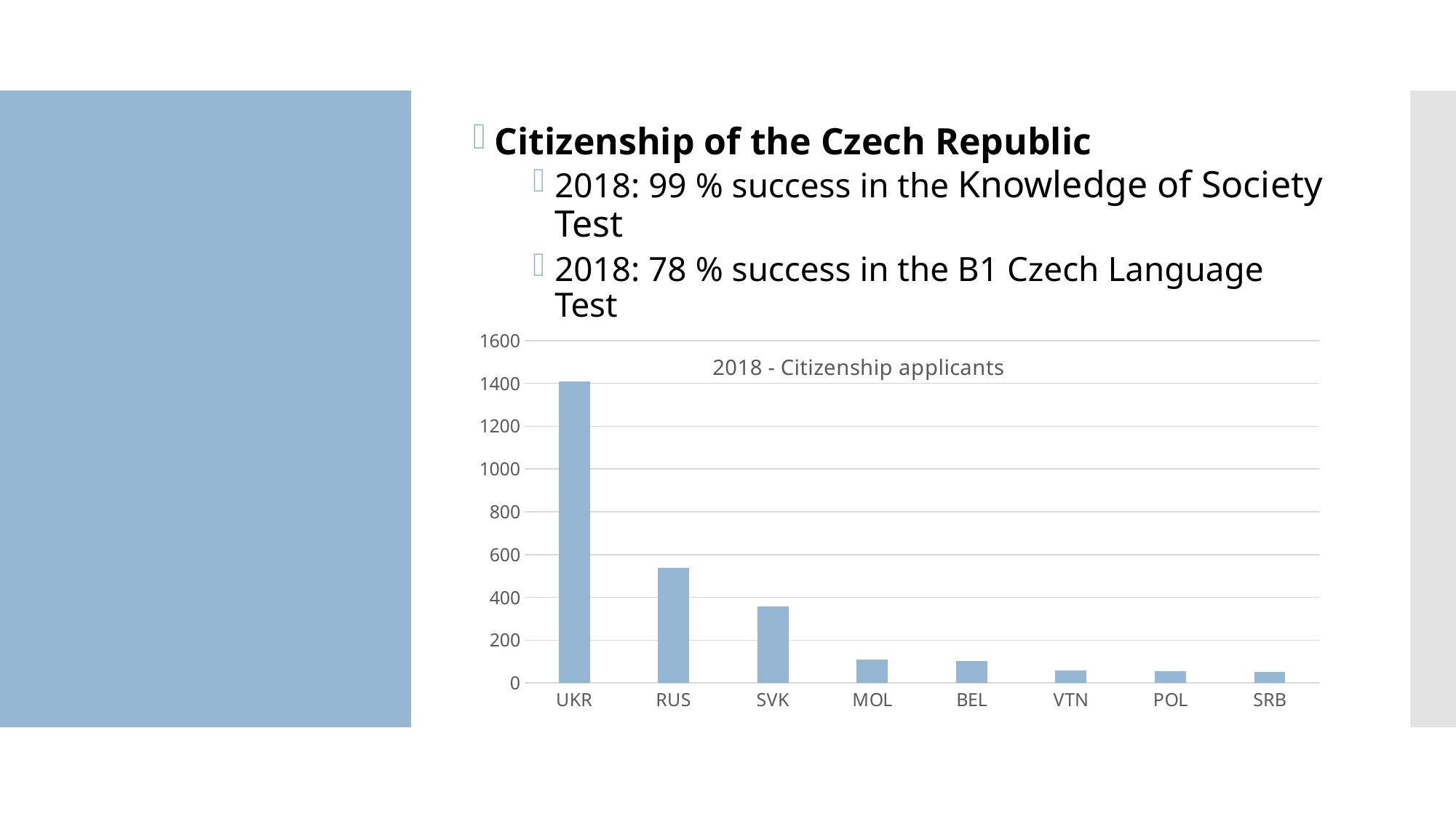
Which has more citizenship applicants, MOL or VTN? MOL Do the values rise or fall moving from left to right along the x axis? fall Is the value for MOL greater or less than 200? less Is the value for RUS greater or less than 600? less What type of chart is shown on the slide? bar chart How many countries are shown on the x axis of the chart? 8 Is the value for RUS greater or less than 400? greater Which has more citizenship applicants, RUS or SVK? RUS Which country has the highest number of citizenship applicants in the chart? UKR What is the title of the chart? 2018 - Citizenship applicants